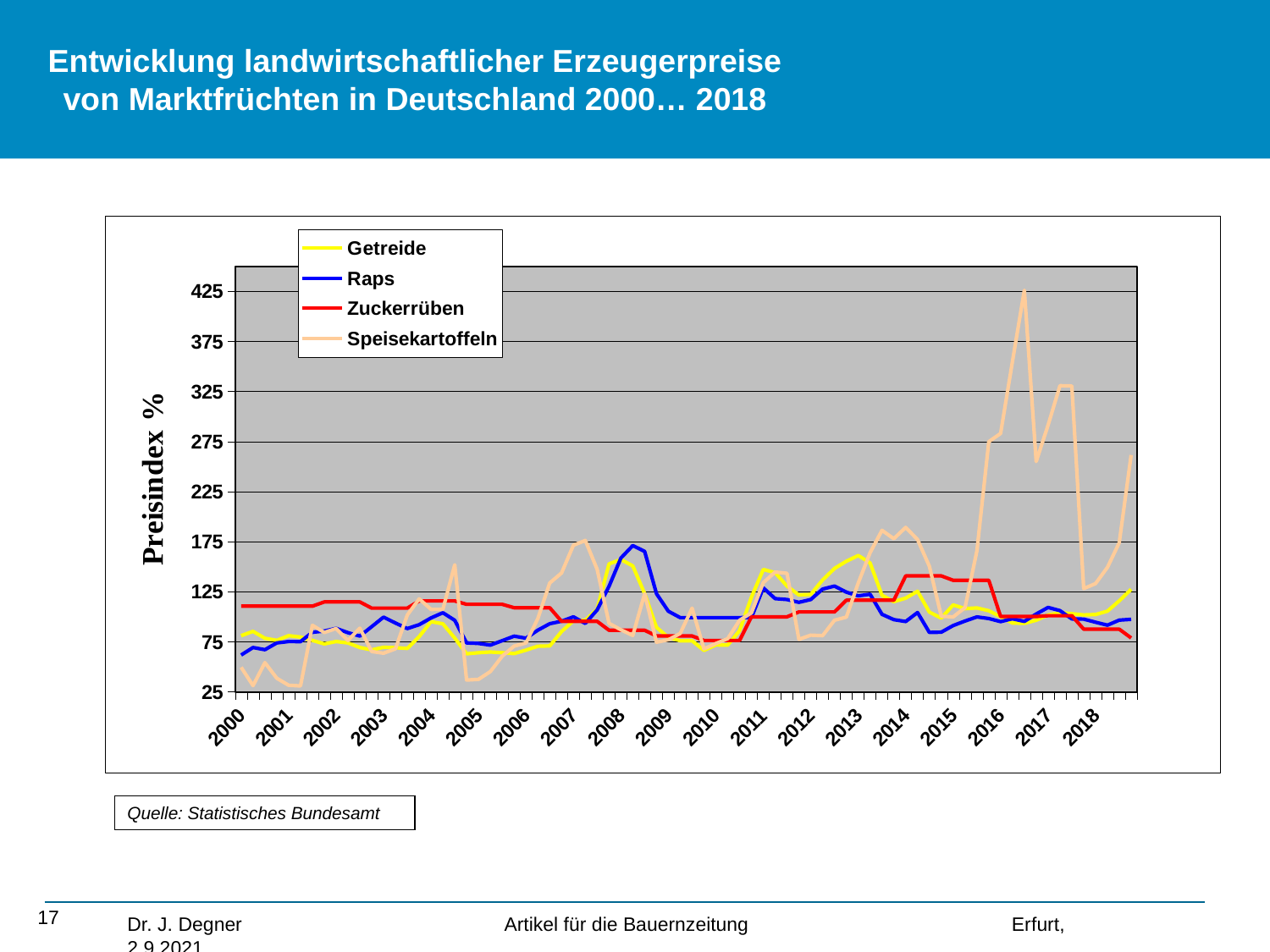
In 2016, which is higher: Speisekartoffeln or Getreide? Speisekartoffeln What is the label of the y axis? Preisindex % How many series does the legend list? 4 How many years are labelled on the x axis? 19 Is the value for Zuckerrüben in 2014 greater or less than 125? greater What kind of chart is shown on the slide? line chart Is the value for Speisekartoffeln at the start of 2005 greater or less than 75? less Is the peak value of Speisekartoffeln around 2016/2017 greater or less than 375? greater What colour is the Raps line? blue At the 2008 peak, which is higher: Raps or Zuckerrüben? Raps Which series reaches the highest value anywhere on the chart? Speisekartoffeln